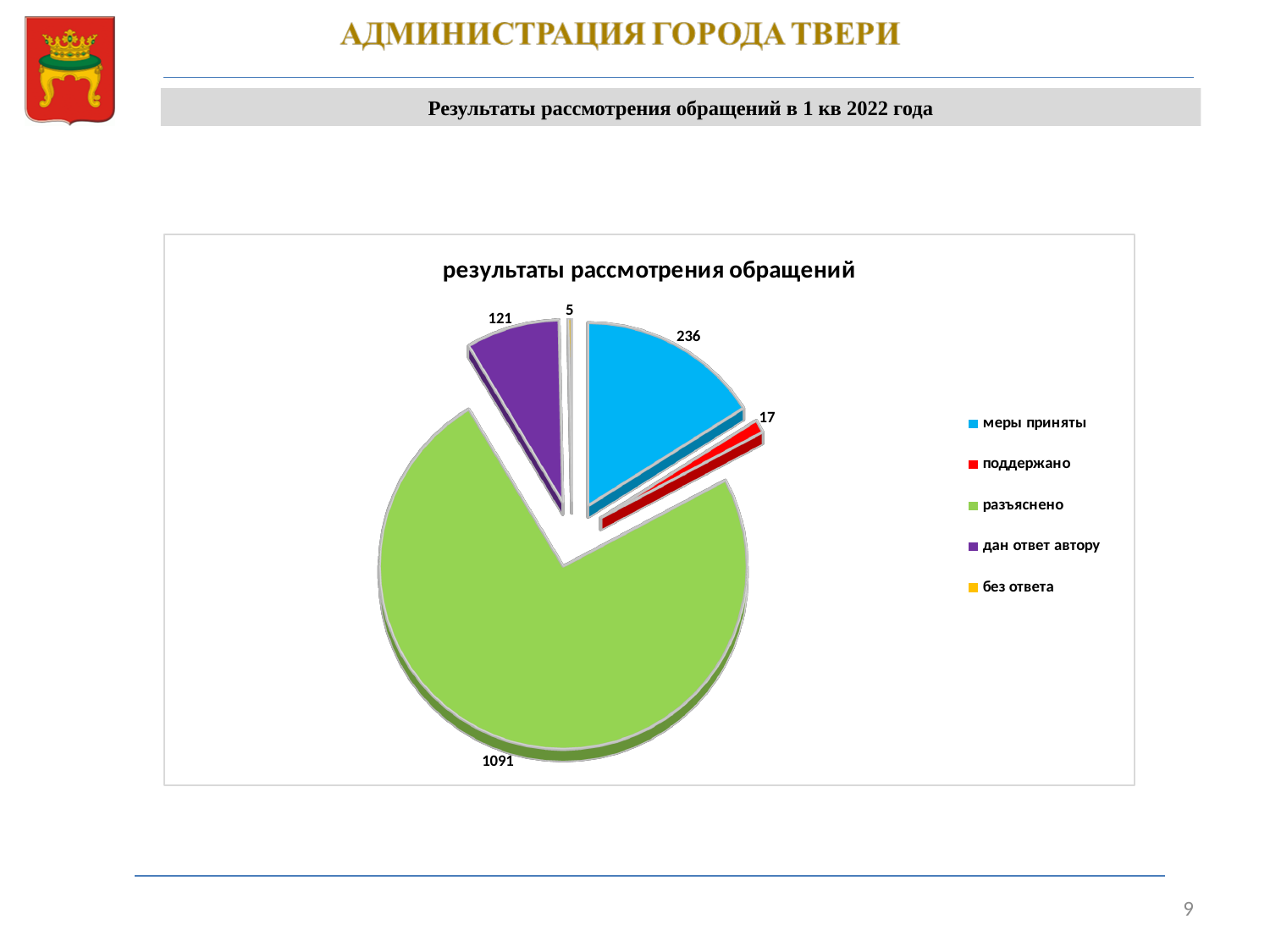
What is the value for 'без ответа' in the pie chart? 5 What is the value for 'разъяснено' in the pie chart? 1091 What is the value for 'дан ответ автору' in the pie chart? 121 What is the value for 'поддержано' in the pie chart? 17 Which is larger: the value for 'поддержано' or the value for 'без ответа'? поддержано What type of chart is shown on the slide? pie chart How many categories does the legend of the pie chart list? 5 Which category has the smallest slice in the pie chart? без ответа What is the title of the chart? результаты рассмотрения обращений What is the difference between the values for 'меры приняты' and 'дан ответ автору'? 115 What is the value for 'меры приняты' in the pie chart? 236 Which category has the largest slice in the pie chart? разъяснено